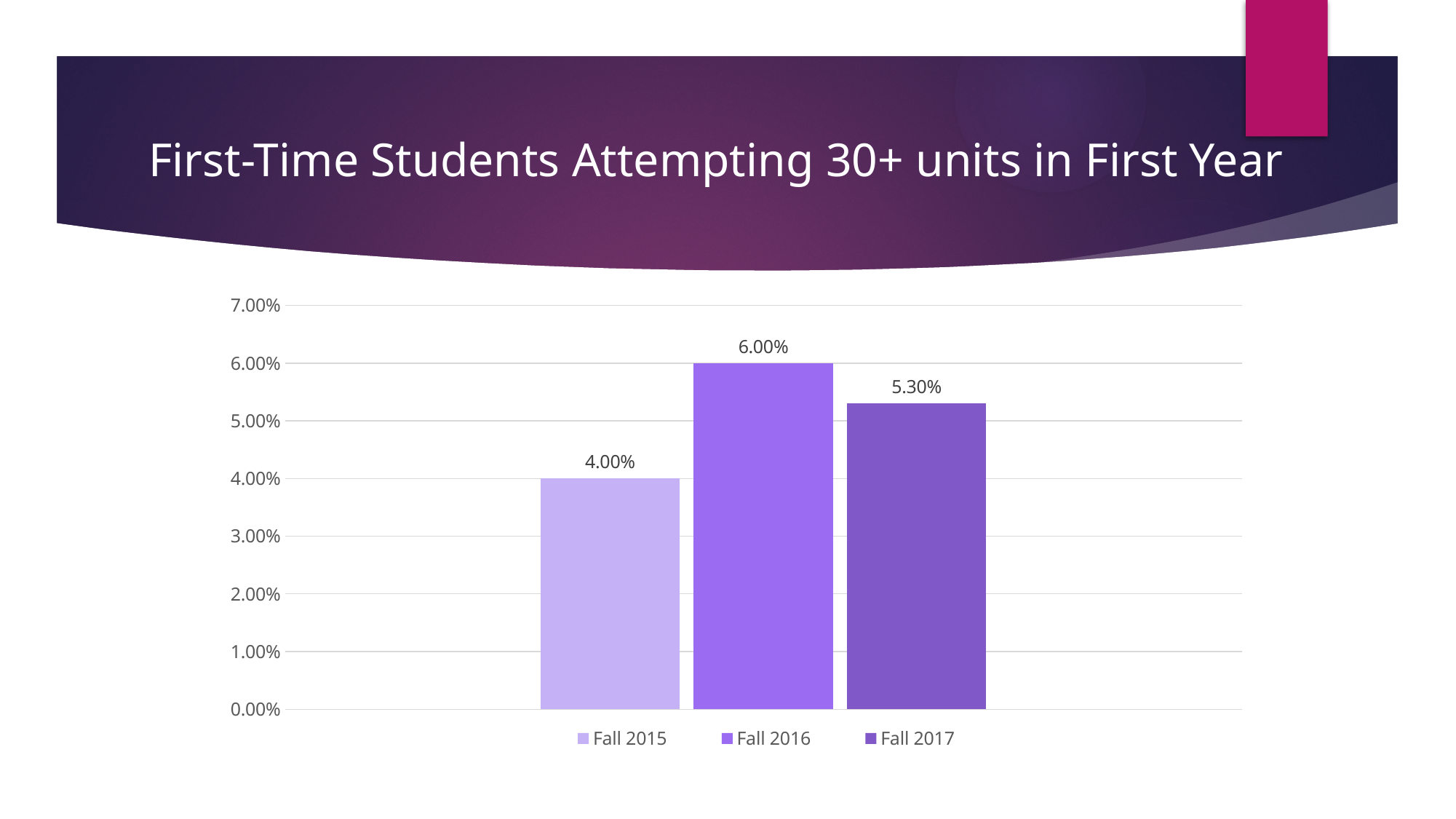
Which is larger, the value for Fall 2017 or the value for Fall 2015? Fall 2017 Is the value for Fall 2017 greater or less than 5.00%? greater How many series does the legend list? 3 What is the title of the slide? First-Time Students Attempting 30+ units in First Year What is the value for Fall 2017? 5.30% What kind of chart is shown on the slide? Bar chart Which series has the lowest value? Fall 2015 What is the difference between the Fall 2016 and Fall 2015 values? 2.00% What is the value for Fall 2016? 6.00% What is the value for Fall 2015? 4.00% Which series has the highest value? Fall 2016 What is the difference between the Fall 2016 and Fall 2017 values? 0.70%